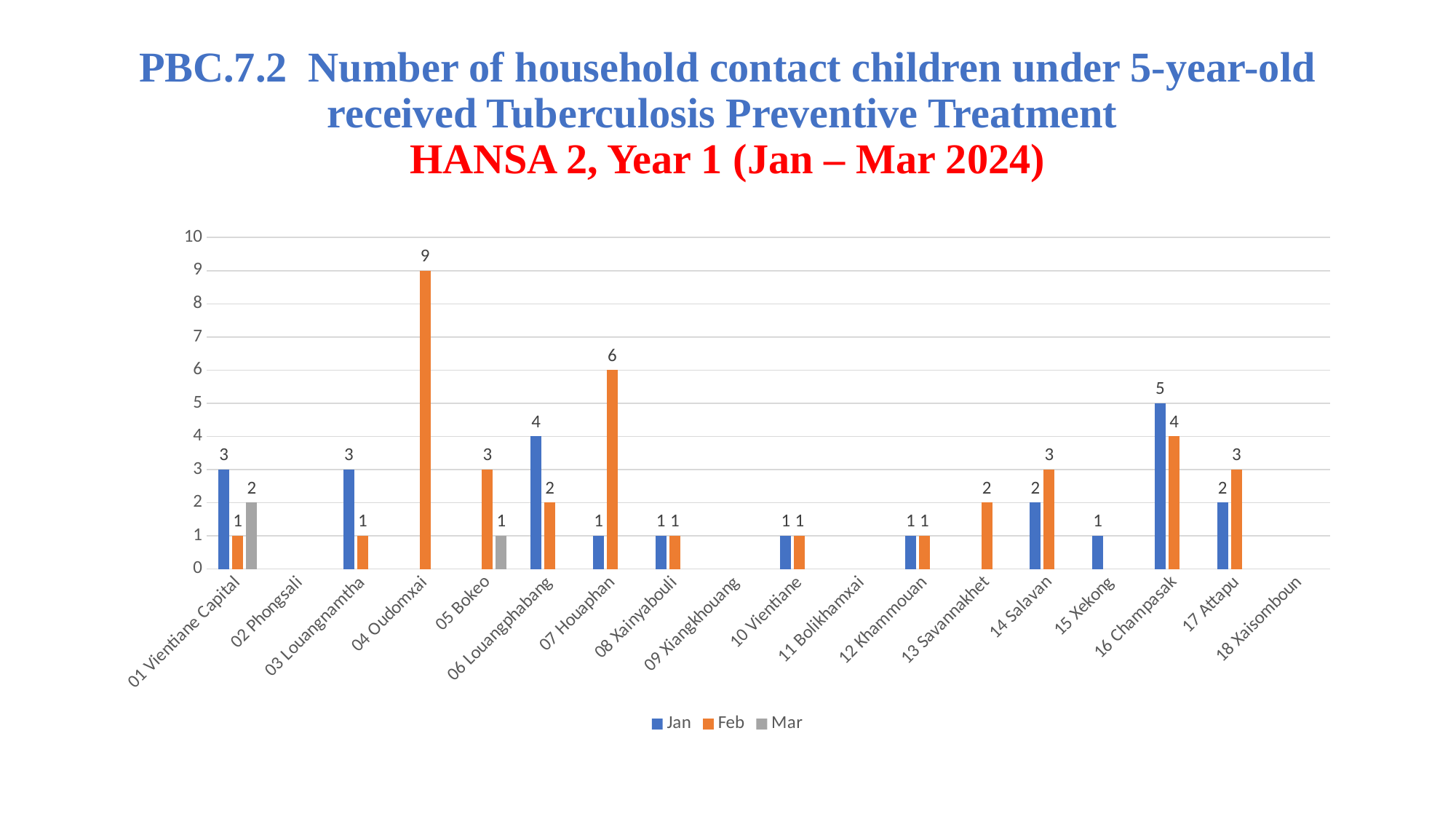
What is the Feb value for 04 Oudomxai? 9 Which province has the highest Feb value? 04 Oudomxai Which province has the highest Jan value? 16 Champasak What is the difference between the Feb and Jan values for 07 Houaphan? 5 What is the Feb value for 07 Houaphan? 6 Which is larger for 14 Salavan, the Jan value or the Feb value? Feb Is the Feb value for 04 Oudomxai greater or less than 8? greater What kind of chart is shown on the slide? Bar chart What is the Jan value for 16 Champasak? 5 How many provinces are listed on the x axis? 18 How many series does the legend list? 3 What is the Mar value for 01 Vientiane Capital? 2